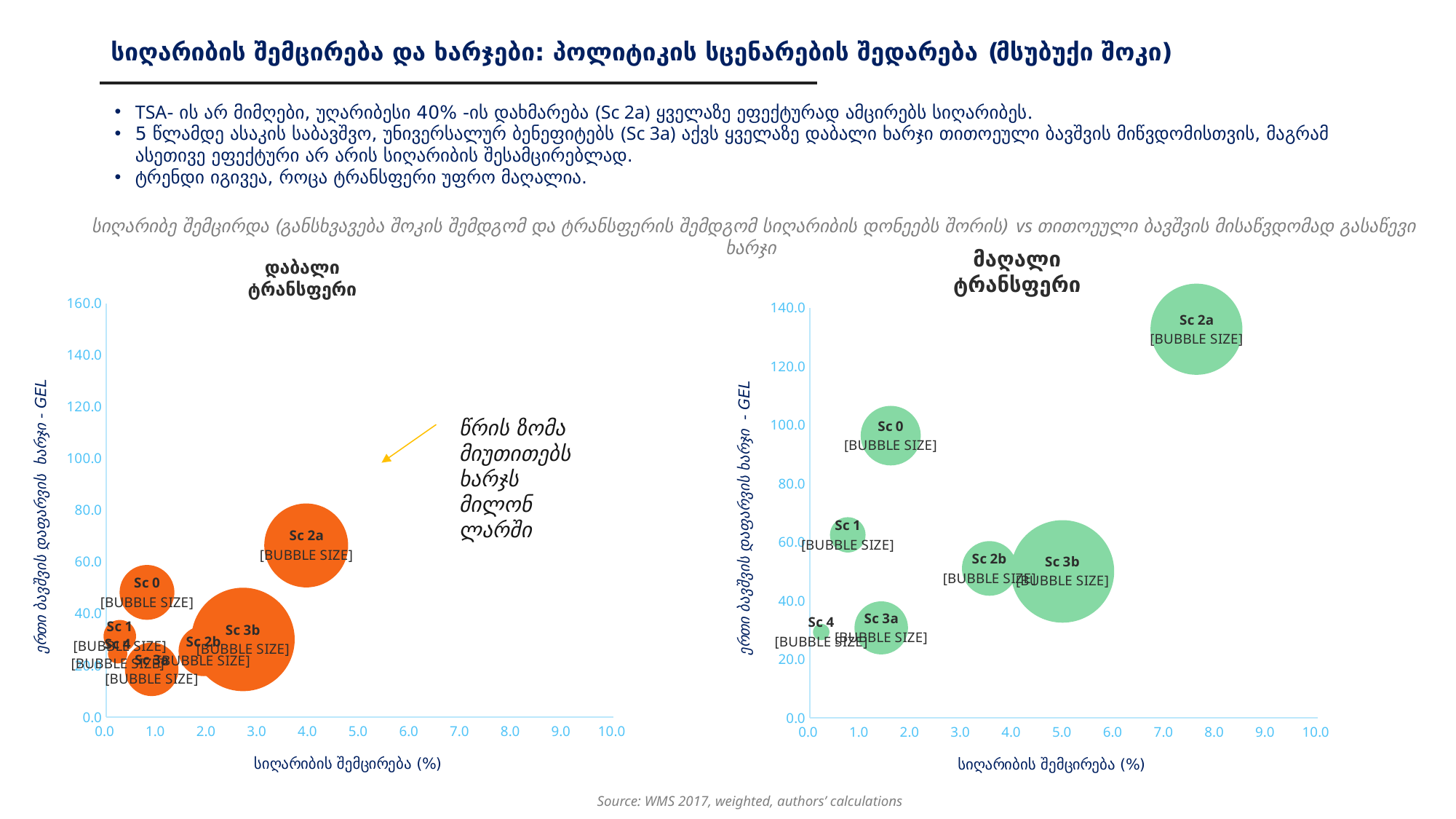
What is the source cited below the charts? WMS 2017, weighted, authors' calculations In the left chart (დაბალი ტრანსფერი), how many scenario bubbles are plotted? 7 In the right chart (მაღალი ტრანსფერი), which has the higher cost per child, Sc 0 or Sc 1? Sc 0 In the left chart (დაბალი ტრანსფერი), is the cost per child for Sc 0 greater or less than 40.0? greater In the right chart (მაღალი ტრანსფერი), which scenario has the highest poverty reduction (x axis)? Sc 2a In the right chart (მაღალი ტრანსფერი), is the cost per child for Sc 0 greater or less than 80.0? greater In the left chart (დაბალი ტრანსფერი), is the poverty reduction for Sc 2a greater or less than 3.0? greater In the left chart (დაბალი ტრანსფერი), which has the larger poverty reduction, Sc 3b or Sc 0? Sc 3b What kind of chart is used on this slide for the two panels? bubble chart In the left chart (დაბალი ტრანსფერი), which scenario has the highest cost per child (y axis)? Sc 2a In the right chart (მაღალი ტრანსფერი), which scenario has the highest cost per child (y axis)? Sc 2a